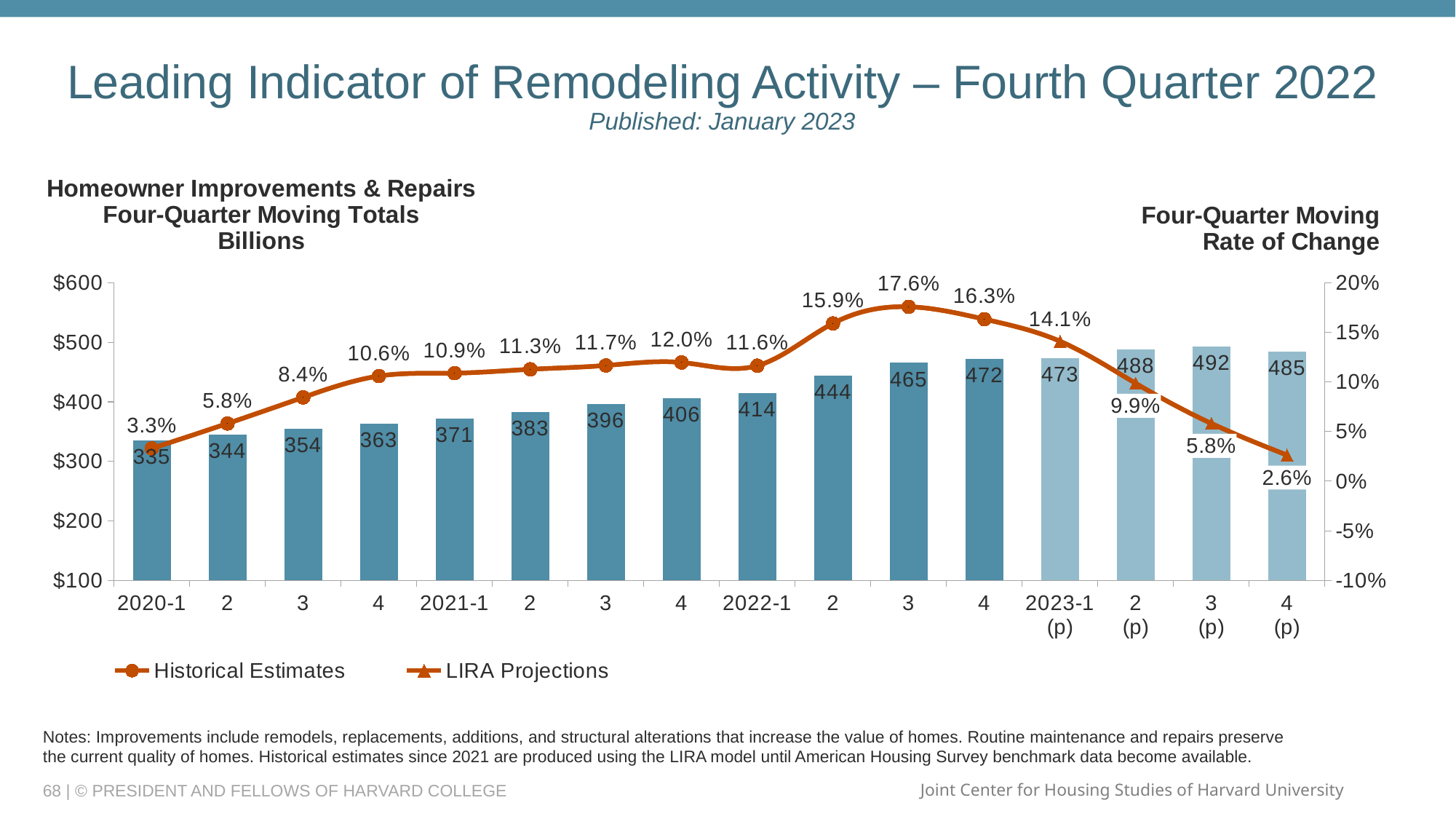
How many quarters are shown on the x axis? 16 What is the four-quarter moving rate of change for 2022-3? 17.6% What is the difference between the four-quarter moving totals for 2023-3 (p) and 2020-1? 157 Which quarter has the highest four-quarter moving rate of change? 2022-3 Which is larger, the rate of change for 2022-2 or for 2023-1 (p)? 2022-2 What is the trend of the four-quarter moving rate of change from 2022-3 to 2023-4 (p)? falling How many series does the legend list? 2 What is the four-quarter moving total (in billions) for 2022-4? 472 What is the projected four-quarter moving total for 2023-3 (p)? 492 Which quarter has the lowest four-quarter moving total? 2020-1 What are the two series named in the legend? Historical Estimates and LIRA Projections Is the four-quarter moving total for 2021-4 greater or less than $400? greater